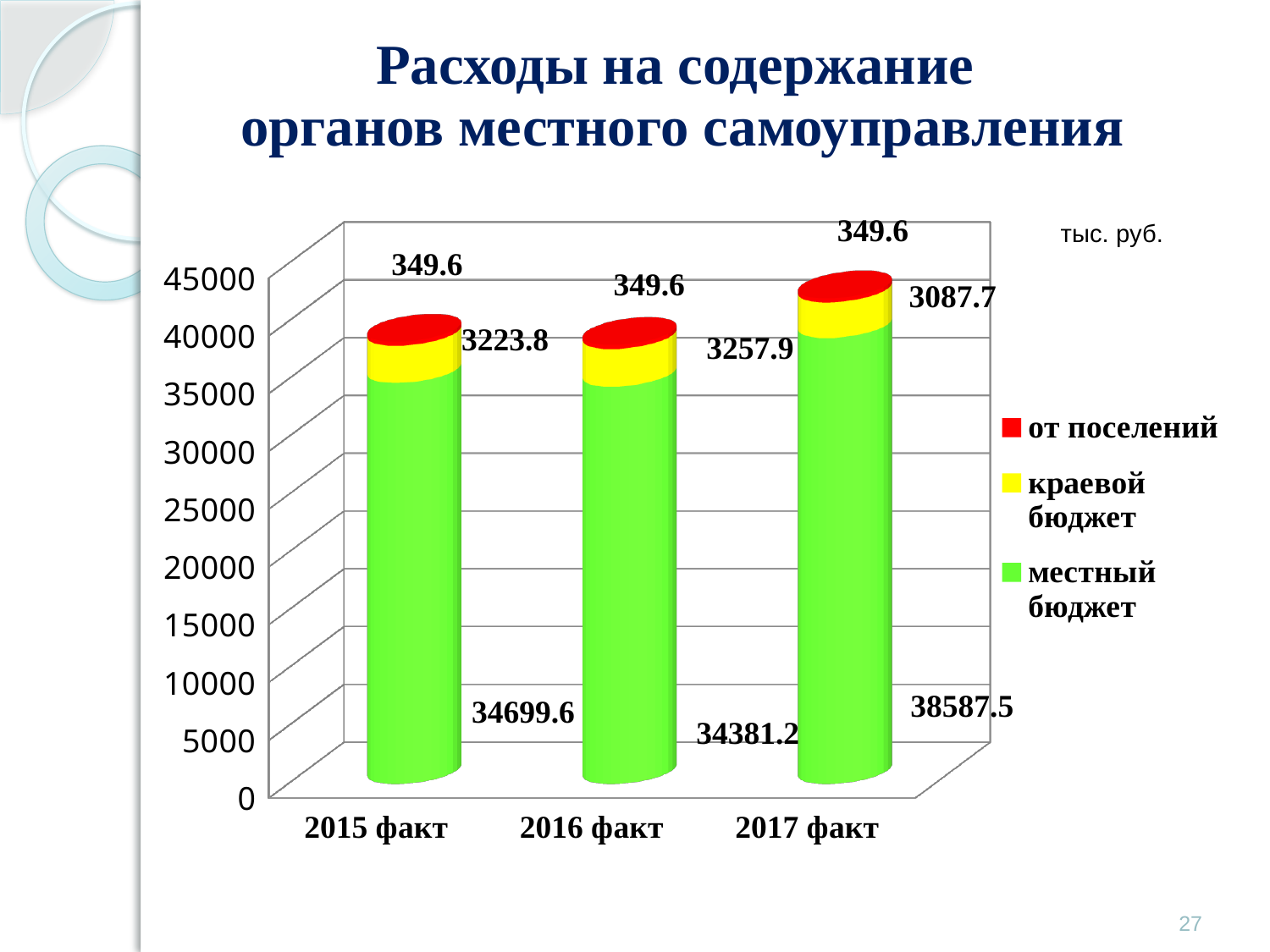
Which year has the highest value for местный бюджет? 2017 факт Which year has the lowest value for краевой бюджет? 2017 факт What is the value of от поселений for 2017 факт? 349.6 How many categories are shown on the x axis? 3 What is the value of краевой бюджет for 2017 факт? 3087.7 What is the total of the stacked bar for 2017 факт? 42024.8 What is the value of местный бюджет for 2015 факт? 34699.6 Which is larger: краевой бюджет in 2015 факт or in 2016 факт? 2016 факт What is the value of краевой бюджет for 2016 факт? 3257.9 What is the difference between местный бюджет in 2017 факт and 2016 факт? 4206.3 How many series does the legend list? 3 What kind of chart is shown on the slide? Stacked bar chart